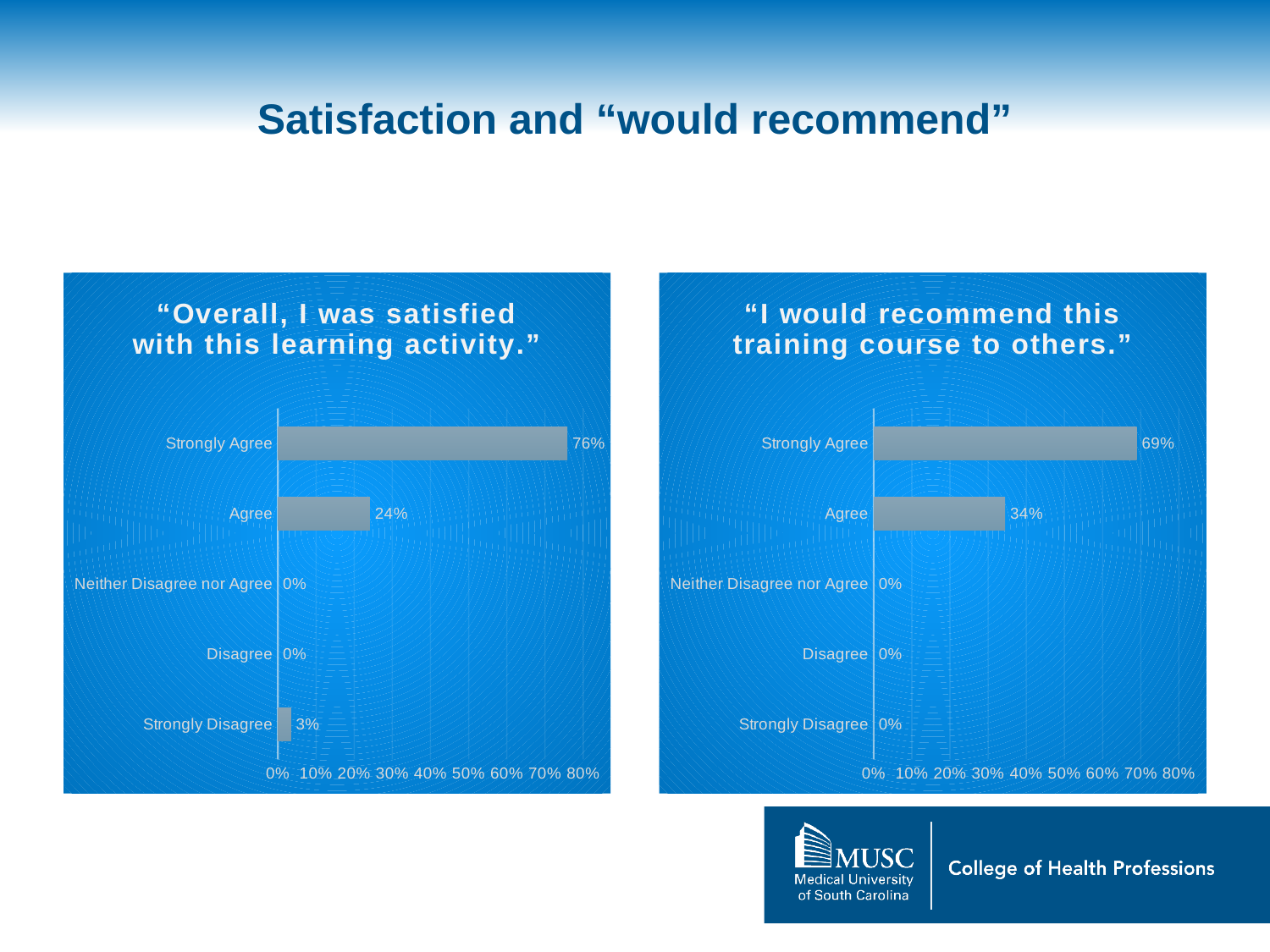
In the "Overall, I was satisfied with this learning activity." chart, what is the value for Strongly Agree? 76% In the "I would recommend this training course to others." chart, what is the value for Disagree? 0% In the "Overall, I was satisfied with this learning activity." chart, what is the difference between the Strongly Agree and Agree values? 52% In the "I would recommend this training course to others." chart, what is the difference between the Strongly Agree and Agree values? 35% In the "Overall, I was satisfied with this learning activity." chart, what is the value for Agree? 24% In the "I would recommend this training course to others." chart, which category has the highest value? Strongly Agree How many categories are shown in the "I would recommend this training course to others." chart? 5 In the "I would recommend this training course to others." chart, what is the value for Strongly Agree? 69% In the "Overall, I was satisfied with this learning activity." chart, what is the value for Strongly Disagree? 3% Which chart has the larger Strongly Agree value, the left chart or the right chart? The left chart In the "Overall, I was satisfied with this learning activity." chart, which category has the highest value? Strongly Agree In the "I would recommend this training course to others." chart, what is the value for Agree? 34%